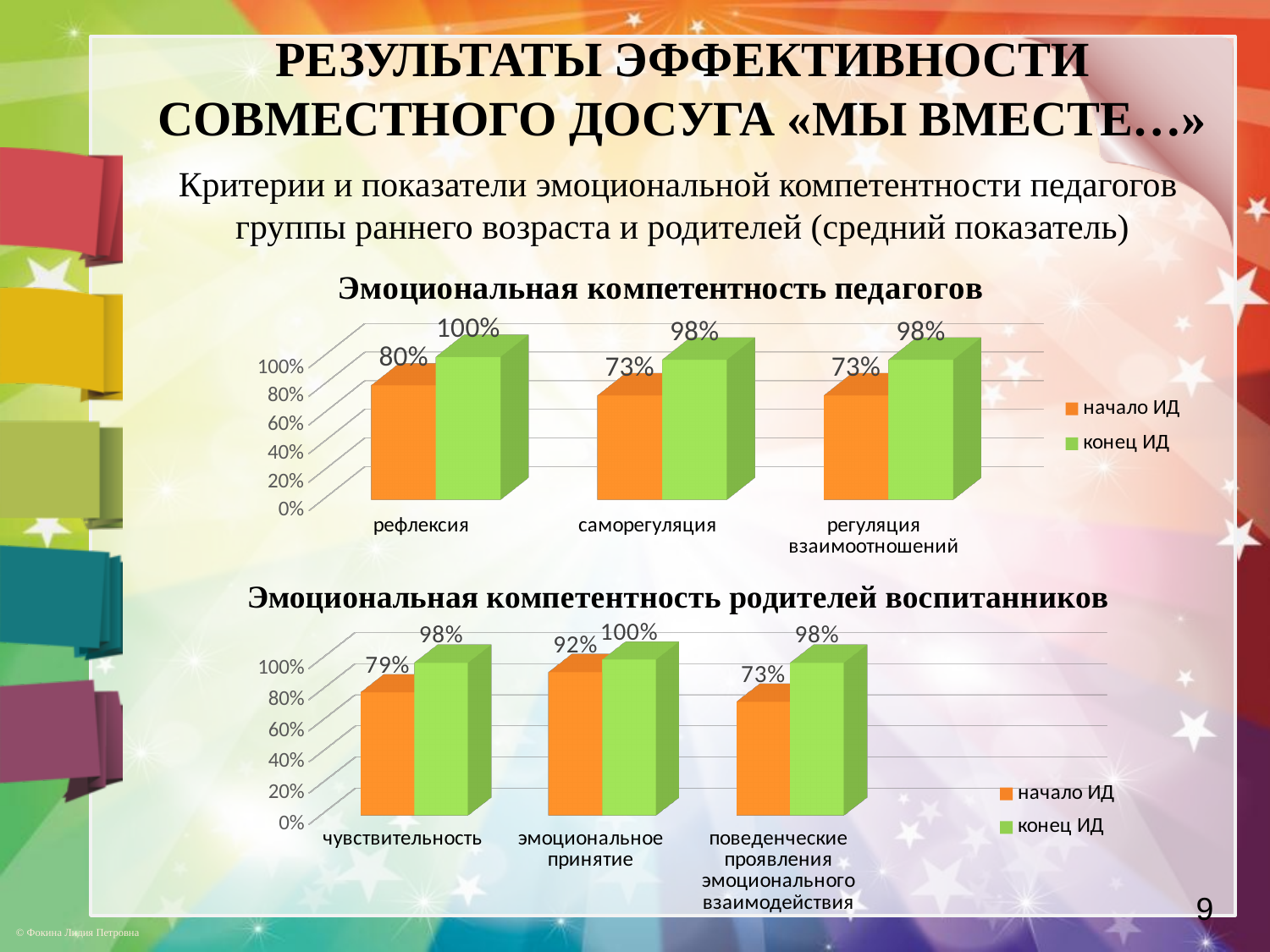
In the chart 'Эмоциональная компетентность педагогов', what is the value of 'начало ИД' for 'рефлексия'? 80% In the chart 'Эмоциональная компетентность родителей воспитанников', what is the value of 'конец ИД' for 'чувствительность'? 98% In the chart 'Эмоциональная компетентность родителей воспитанников', what is the value of 'начало ИД' for 'эмоциональное принятие'? 92% What type of chart is 'Эмоциональная компетентность педагогов'? bar chart In the chart 'Эмоциональная компетентность педагогов', which category has the highest 'конец ИД' value? рефлексия How many series does the legend of the chart 'Эмоциональная компетентность родителей воспитанников' list? 2 In the chart 'Эмоциональная компетентность педагогов', what is the difference between 'конец ИД' and 'начало ИД' for 'регуляция взаимоотношений'? 25% In the chart 'Эмоциональная компетентность родителей воспитанников', which is larger: 'начало ИД' for 'чувствительность' or 'начало ИД' for 'эмоциональное принятие'? эмоциональное принятие In the chart 'Эмоциональная компетентность педагогов', what is the value of 'конец ИД' for 'саморегуляция'? 98% In the chart 'Эмоциональная компетентность родителей воспитанников', which category has the lowest 'начало ИД' value? поведенческие проявления эмоционального взаимодействия In the chart 'Эмоциональная компетентность педагогов', how many categories are shown on the x axis? 3 In the chart 'Эмоциональная компетентность родителей воспитанников', what is the difference between 'конец ИД' and 'начало ИД' for 'чувствительность'? 19%